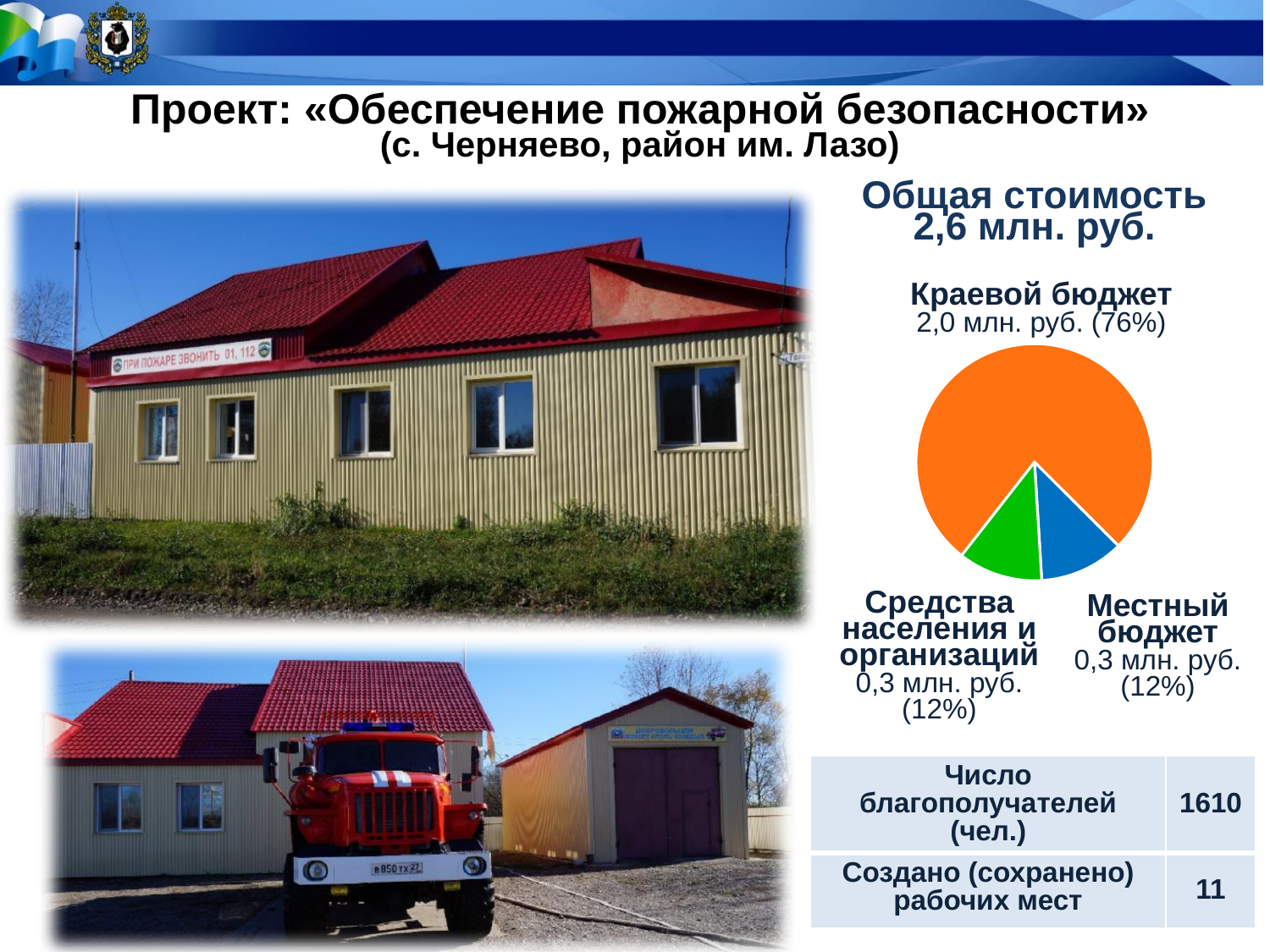
What is the value shown for Местный бюджет? 0,3 млн. руб. Which slice of the pie chart is the largest? Краевой бюджет What is the value shown for Краевой бюджет? 2,0 млн. руб. What is the difference between the Краевой бюджет value and the Местный бюджет value? 1,7 млн. руб. What is the total cost (Общая стоимость) shown above the pie chart? 2,6 млн. руб. What share of the pie chart does Краевой бюджет account for? 76% Which is larger, Краевой бюджет or Местный бюджет? Краевой бюджет What kind of chart is shown on the slide? pie chart What colour is the Краевой бюджет slice in the pie chart? orange What is the difference in percentage points between the Краевой бюджет share and the Средства населения и организаций share? 64% What share of the pie chart does Средства населения и организаций account for? 12% How many slices does the pie chart have? 3